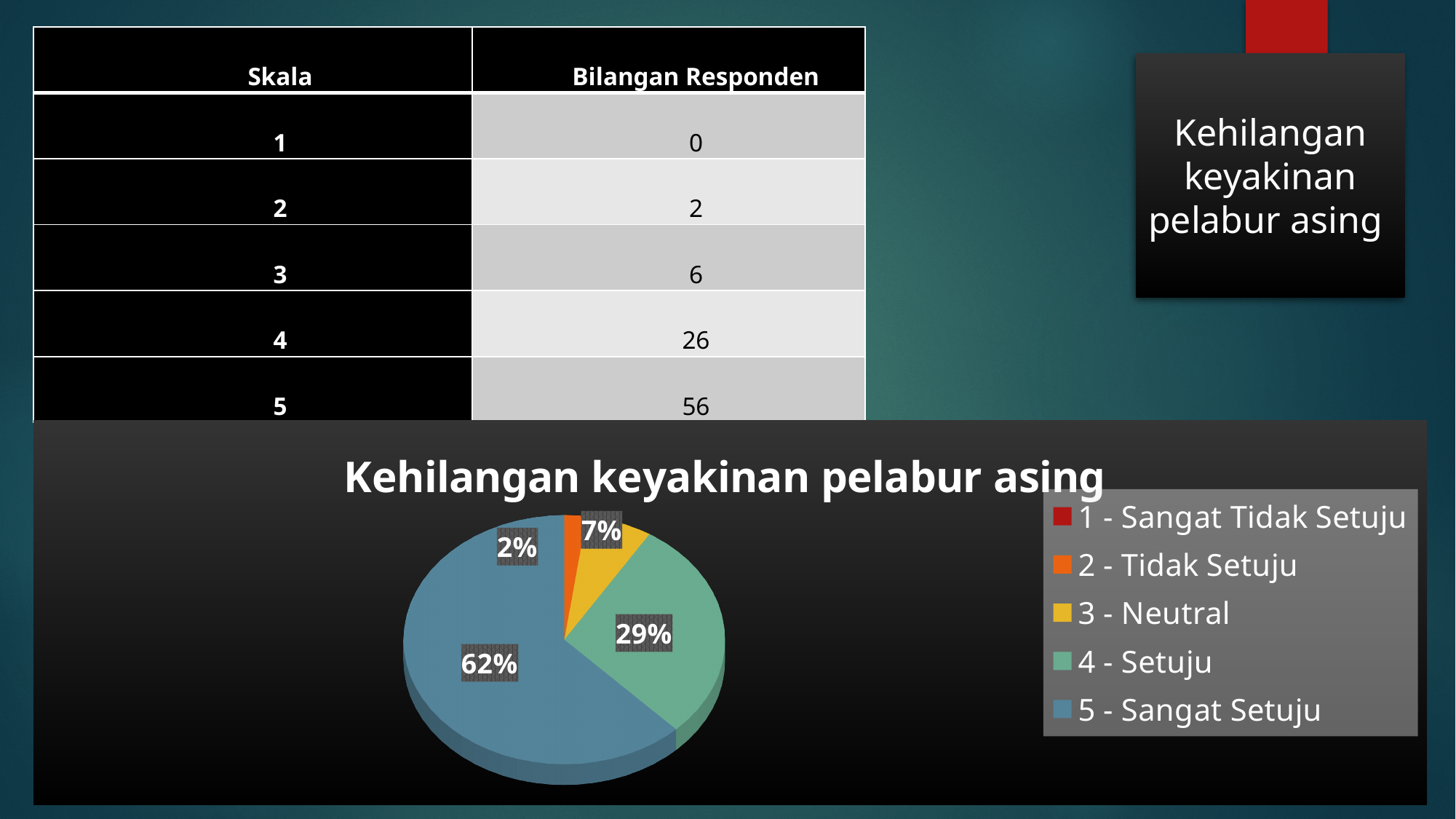
What colour is the 5 - Sangat Setuju slice? blue What share of the pie does 2 - Tidak Setuju have? 2% Which slice is larger, 4 - Setuju or 3 - Neutral? 4 - Setuju What share of the pie does 3 - Neutral have? 7% What type of chart is shown on the slide? pie chart What share of the pie does 4 - Setuju have? 29% What is the title of the chart? Kehilangan keyakinan pelabur asing Which category has the largest slice of the pie? 5 - Sangat Setuju What is the difference in percentage points between the 5 - Sangat Setuju slice and the 4 - Setuju slice? 33% What is the difference in percentage points between the 3 - Neutral slice and the 2 - Tidak Setuju slice? 5% How many entries does the legend list? 5